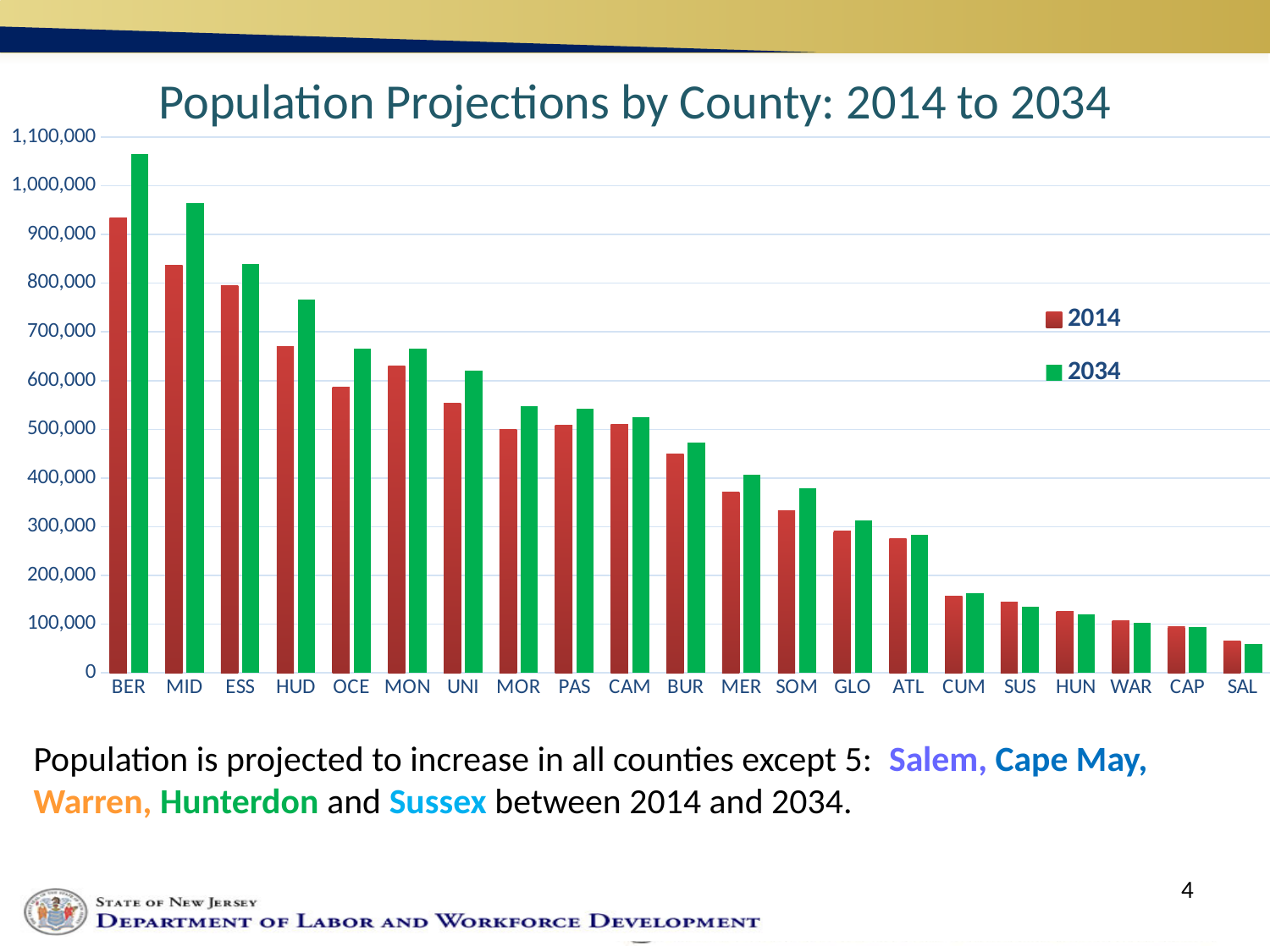
Do the 2014 values generally rise or fall moving from left to right along the x axis? fall Is the 2034 value for BER greater or less than 1,000,000? greater Is the 2034 value for MID greater or less than 1,000,000? less Which county has the lowest population for 2014? SAL Which is larger for 2034: HUD or OCE? HUD How many series does the legend list? 2 How many counties are shown on the x axis of the chart? 21 Is the 2034 value for SAL greater or less than 100,000? less What is the title of the chart? Population Projections by County: 2014 to 2034 Which county has the highest projected population for 2034? BER What kind of chart is shown on the slide? bar chart